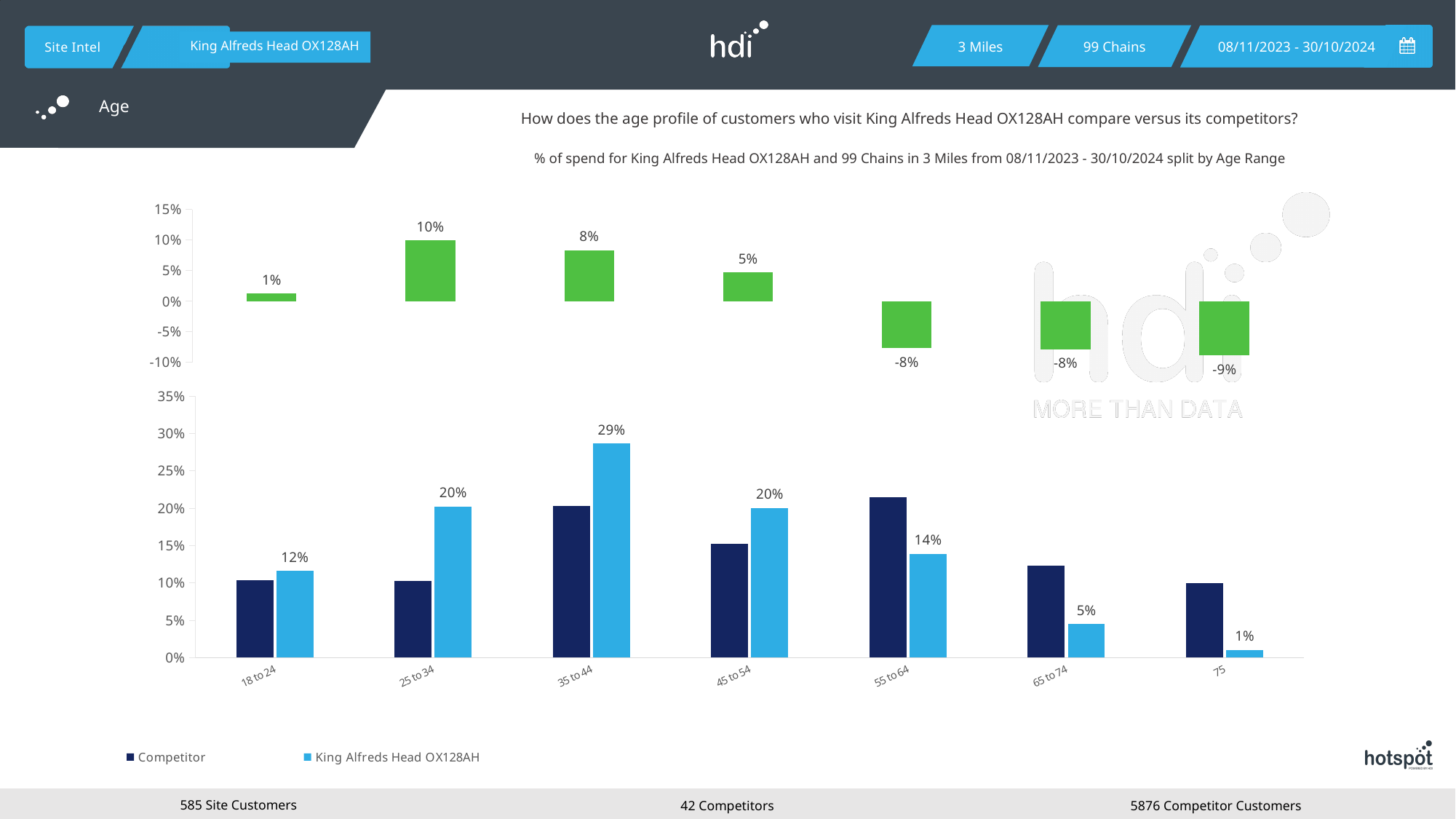
How many series does the legend of the bottom chart list? 2 In the top chart, which age range has the highest value? 25 to 34 In the bottom chart, which age range has the lowest value for King Alfreds Head OX128AH? 75 In the bottom chart, what is the value for King Alfreds Head OX128AH in the 65 to 74 age range? 5% In the top chart, what is the value shown for the 25 to 34 age range? 10% In the bottom chart, what is the value for King Alfreds Head OX128AH in the 35 to 44 age range? 29% In the bottom chart, is the Competitor value for 55 to 64 greater or less than 20%? greater In the bottom chart, which is larger for the 55 to 64 age range: the Competitor bar or the King Alfreds Head OX128AH bar? Competitor In the bottom chart, which age range has the highest value for King Alfreds Head OX128AH? 35 to 44 In the bottom chart, what is the difference between the King Alfreds Head OX128AH values for 35 to 44 and 18 to 24? 17% In the top chart, what is the value shown for the 75 age range? -9% How many age range categories are shown on the x axis of the bottom chart? 7